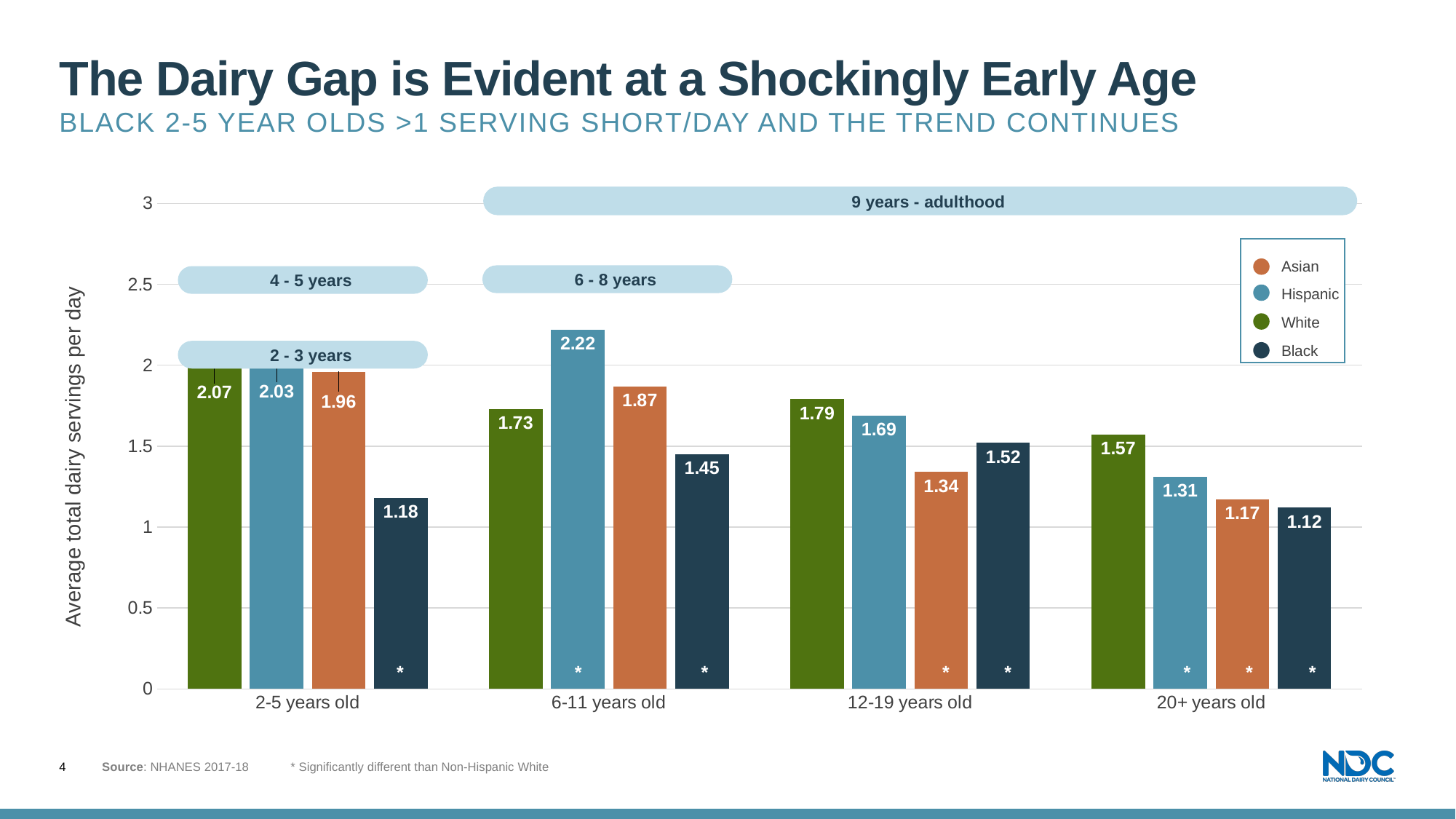
What is the value for Asian 12-19 year olds? 1.34 How many age groups are shown on the x axis? 4 Which is larger for 12-19 year olds: the Black value or the Asian value? Black Is the value for Hispanic 20+ year olds greater or less than 1.5? less How many series does the legend list? 4 What is the average total dairy servings per day for Black 2-5 year olds? 1.18 Which group has the lowest value among 20+ year olds? Black What is the difference between the White and Black values for 2-5 year olds? 0.89 What is the value for Hispanic 6-11 year olds? 2.22 Which group has the highest average total dairy servings per day among 6-11 year olds? Hispanic What is the value for White 20+ year olds? 1.57 What kind of chart is shown on the slide? Bar chart